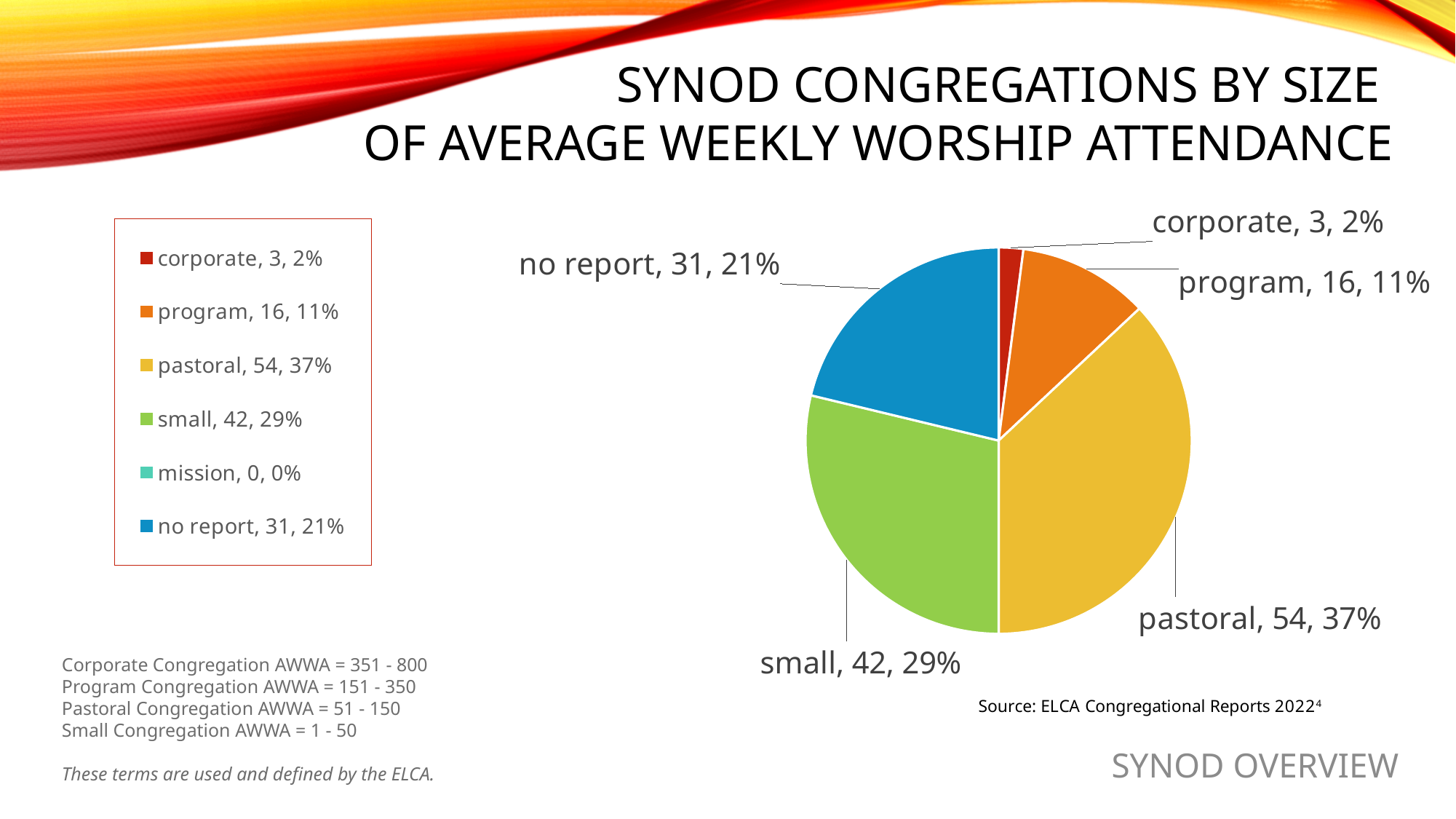
What colour is the slice for the no report category? blue How many congregations are in the pastoral category? 54 What percentage of congregations are in the small category? 29% How many congregations are in the mission category? 0 Which category has the largest share of the pie? pastoral Which category with a non-zero count has the smallest share of the pie? corporate What is the difference in the number of congregations between the pastoral and small categories? 12 What kind of chart is shown on the slide? pie chart What share of the pie does the program category represent? 11% Which category has more congregations, program or no report? no report How many categories does the legend list? 6 How many congregations are in the no report category? 31